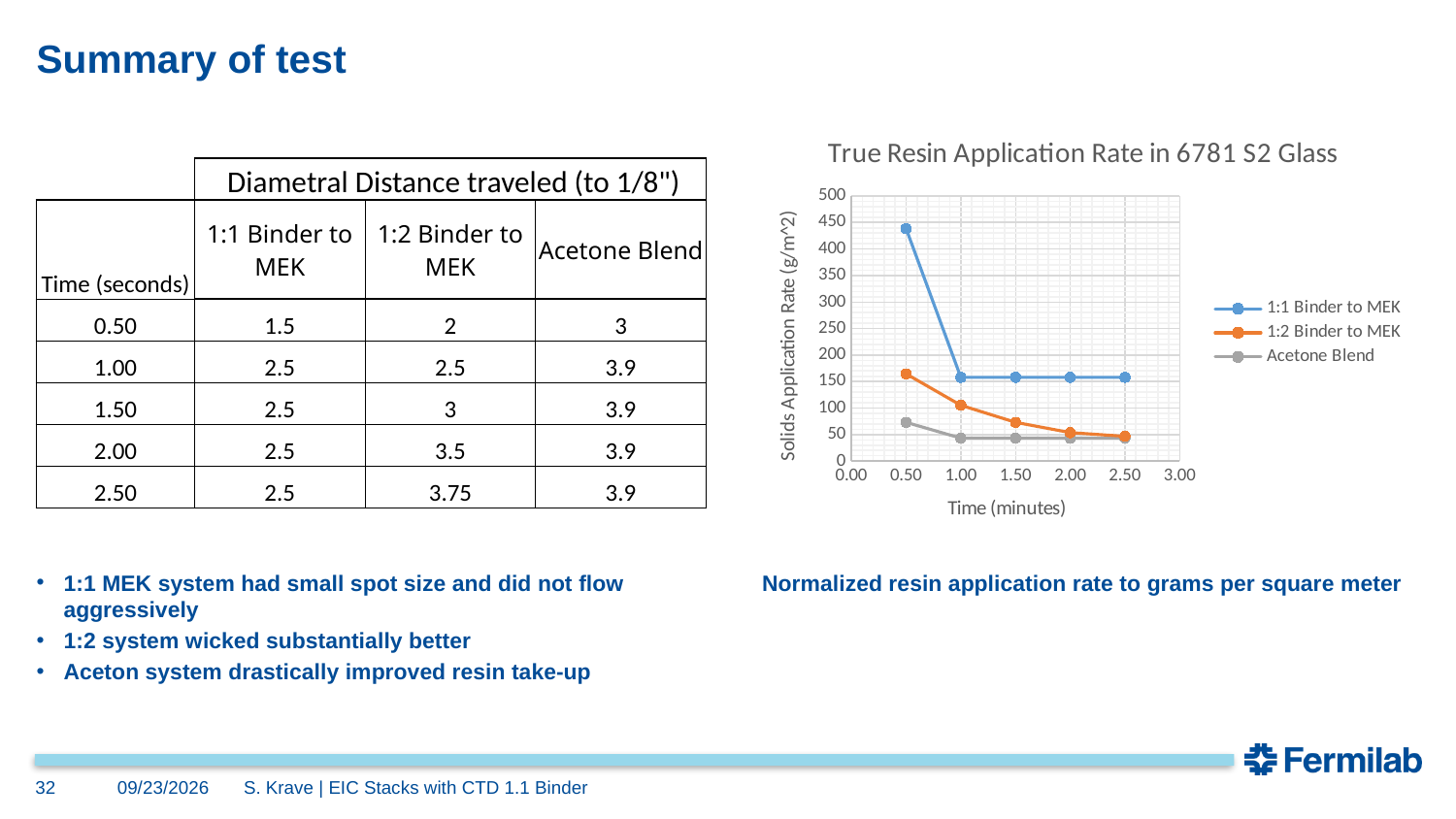
Is the value for 1:2 Binder to MEK at 0.50 minutes greater or less than 200? less How many series does the legend of the chart list? 3 Is the value for 1:1 Binder to MEK at 1.00 minutes greater or less than 200? less What kind of chart is shown on the slide? line chart Which series has the lowest value at 0.50 minutes? Acetone Blend Which series has the highest value at 0.50 minutes? 1:1 Binder to MEK How many data points are plotted for the 1:2 Binder to MEK series? 5 Is the value for Acetone Blend at 0.50 minutes greater or less than 100? less Does the 1:2 Binder to MEK series rise or fall as time increases? fall What is the title of the chart's x axis? Time (minutes) At 2.50 minutes, which is larger: the value for 1:1 Binder to MEK or the value for 1:2 Binder to MEK? 1:1 Binder to MEK